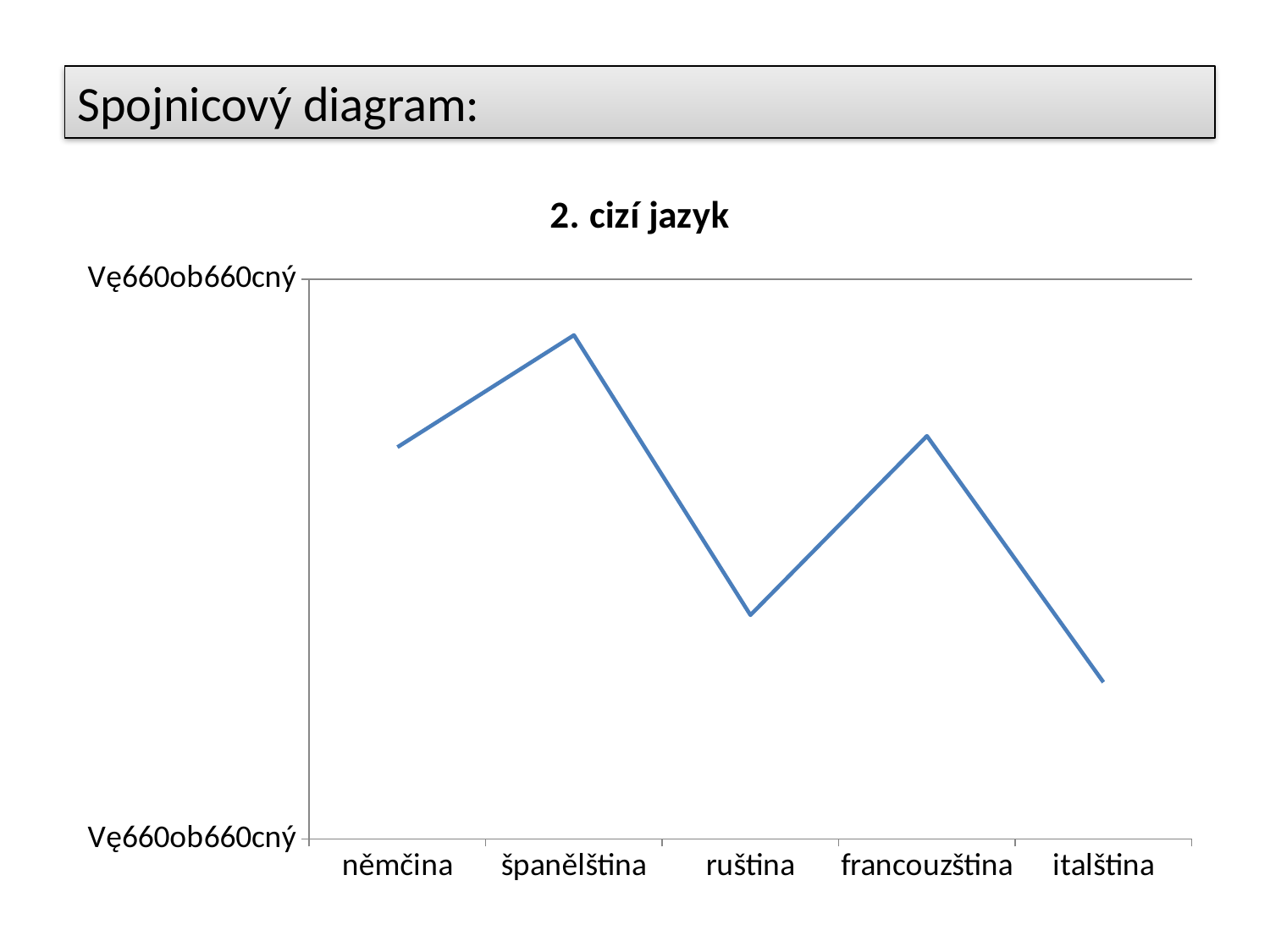
How many categories are plotted along the x axis? 5 Which has the larger value, ruština or italština? ruština Which category has the highest value? španělština Which has the larger value, španělština or italština? španělština What is the title of the chart? 2. cizí jazyk Which has the larger value, němčina or ruština? němčina Which category has the lowest value? italština Does the line rise or fall from němčina to španělština? rise What is the label of the first category on the x axis? němčina Does the line rise or fall from španělština to ruština? fall What kind of chart is shown on the slide? line chart Does the line rise or fall from francouzština to italština? fall